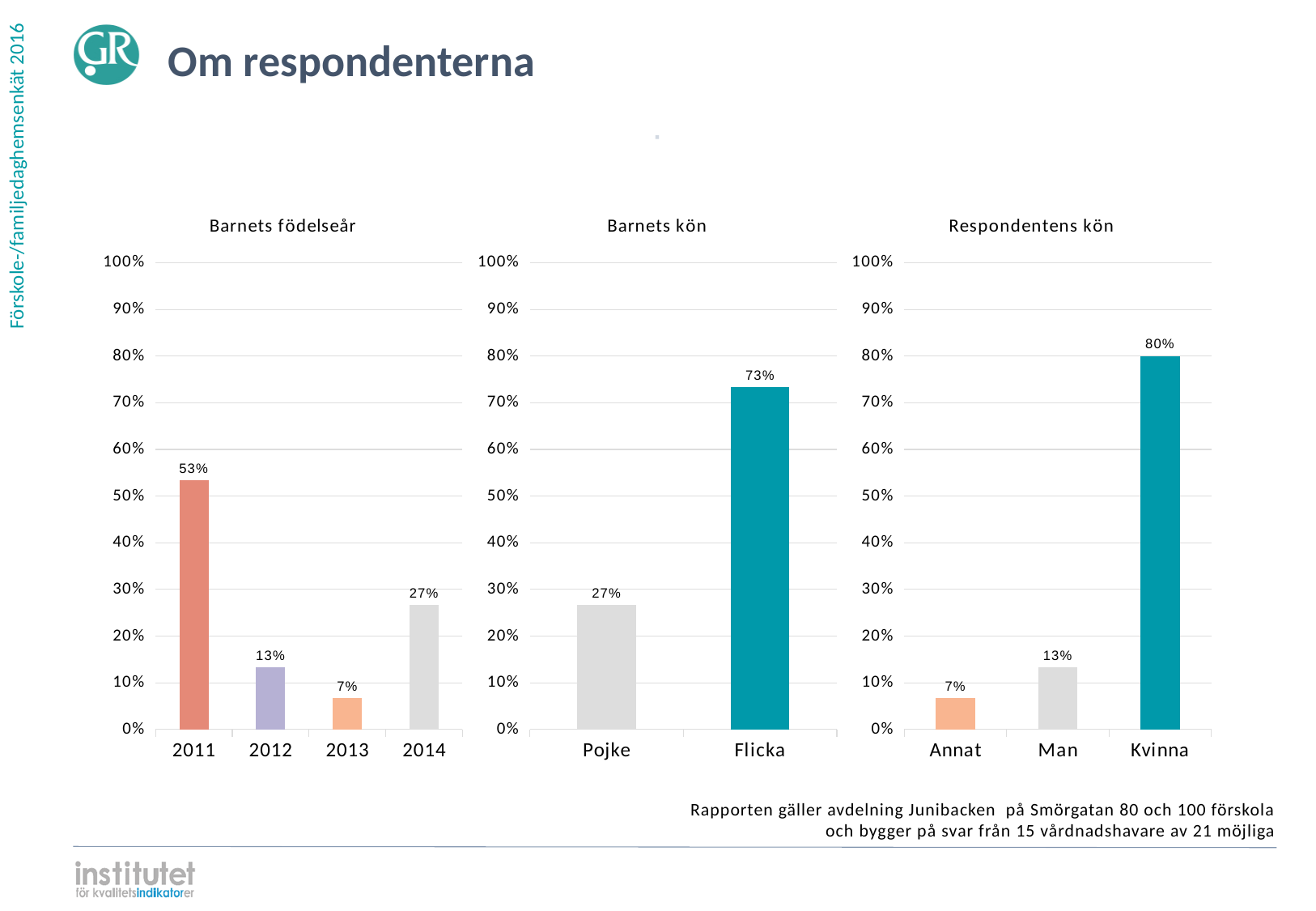
In the 'Barnets kön' chart, which category is higher, Pojke or Flicka? Flicka In the 'Barnets födelseår' chart, how many birth years are shown? 4 In the 'Respondentens kön' chart, what is the value for Kvinna? 80% In the 'Barnets kön' chart, what is the difference between Flicka and Pojke? 46% In the 'Respondentens kön' chart, what is the value for Man? 13% In the 'Barnets födelseår' chart, what is the value for 2011? 53% In the 'Barnets födelseår' chart, which birth year has the lowest value? 2013 In the 'Barnets födelseår' chart, what is the difference between the values for 2011 and 2014? 26% In the 'Respondentens kön' chart, how many categories are shown? 3 In the 'Respondentens kön' chart, which category has the highest value? Kvinna What kind of chart is the 'Barnets kön' chart? Bar chart In the 'Barnets kön' chart, what is the value for Flicka? 73%